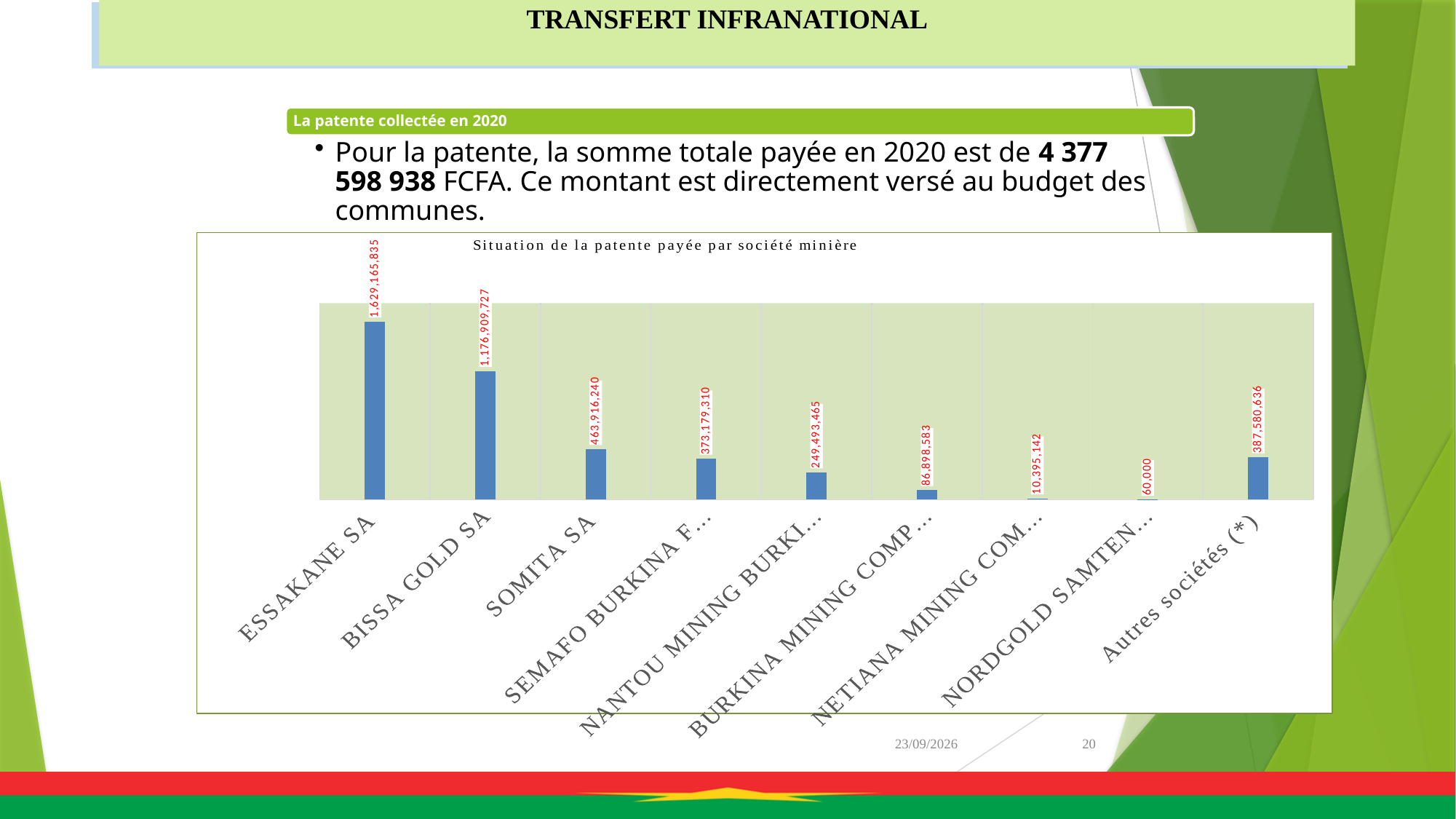
Which is larger, the value for SOMITA SA or the value for Autres sociétés (*)? SOMITA SA What type of chart is shown on the slide? bar chart Which company has the highest value in the chart? ESSAKANE SA What is the value shown for SOMITA SA? 463,916,240 What is the value shown for Autres sociétés (*)? 387,580,636 What is the lowest value shown in the chart? 60,000 What is the value shown for ESSAKANE SA? 1,629,165,835 What is the title of the chart? Situation de la patente payée par société minière What is the difference between the values for SOMITA SA and Autres sociétés (*)? 76,335,604 What is the value shown for BISSA GOLD SA? 1,176,909,727 What is the difference between the values for ESSAKANE SA and BISSA GOLD SA? 452,256,108 How many mining companies/categories are plotted in the chart? 9